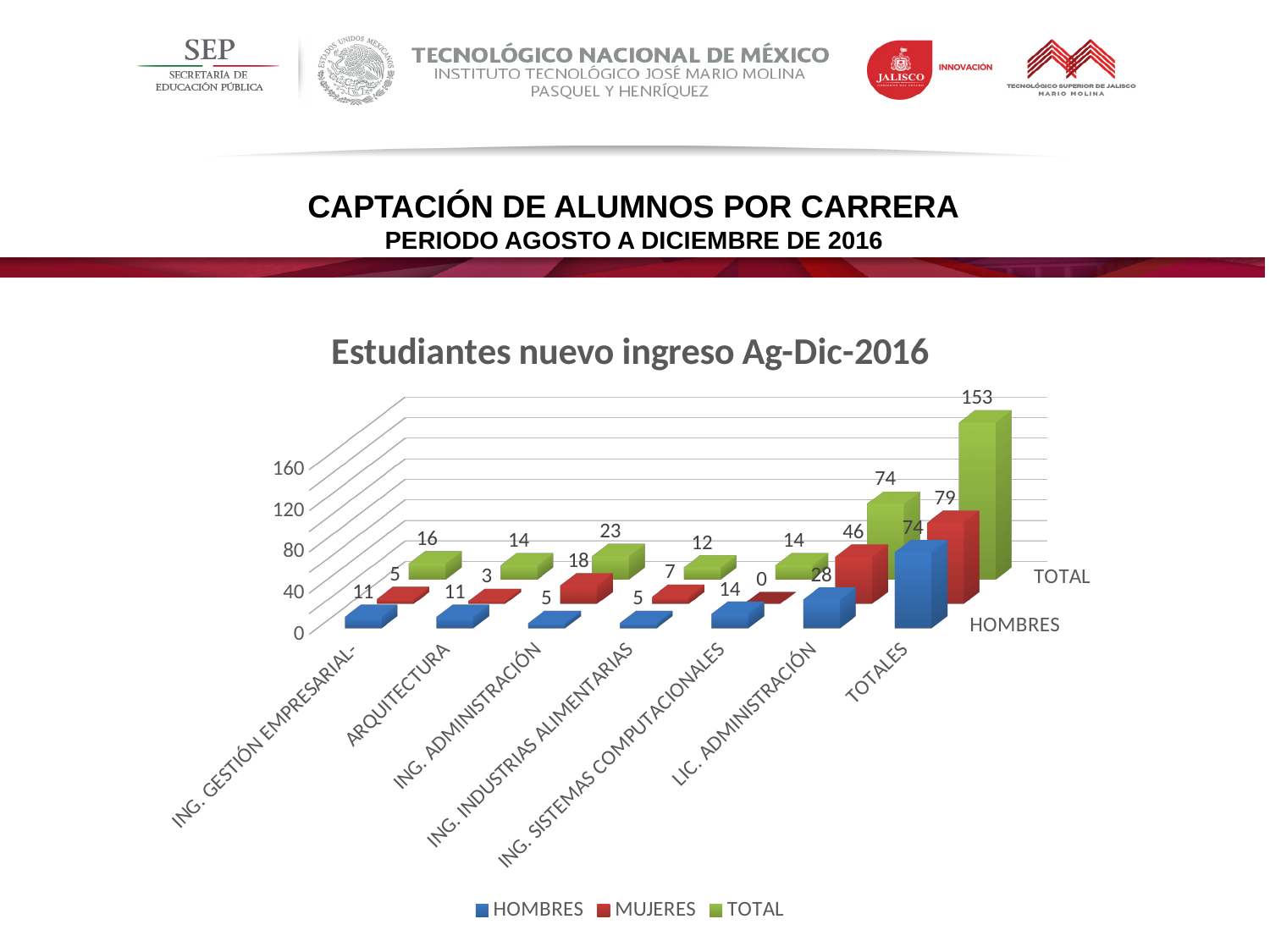
What is the HOMBRES value for LIC. ADMINISTRACIÓN? 28 What is the MUJERES value for ING. ADMINISTRACIÓN? 18 What is the TOTAL value for ING. GESTIÓN EMPRESARIAL? 16 How many series does the legend list? 3 Which is larger for ING. ADMINISTRACIÓN, HOMBRES or MUJERES? MUJERES What is the MUJERES value for ING. SISTEMAS COMPUTACIONALES? 0 What is the TOTAL value for TOTALES? 153 What type of chart is shown? Bar chart How many categories are shown on the x axis? 7 Excluding TOTALES, which career has the lowest TOTAL value? ING. INDUSTRIAS ALIMENTARIAS What is the difference between the MUJERES and HOMBRES values for LIC. ADMINISTRACIÓN? 18 Excluding TOTALES, which career has the highest TOTAL value? LIC. ADMINISTRACIÓN